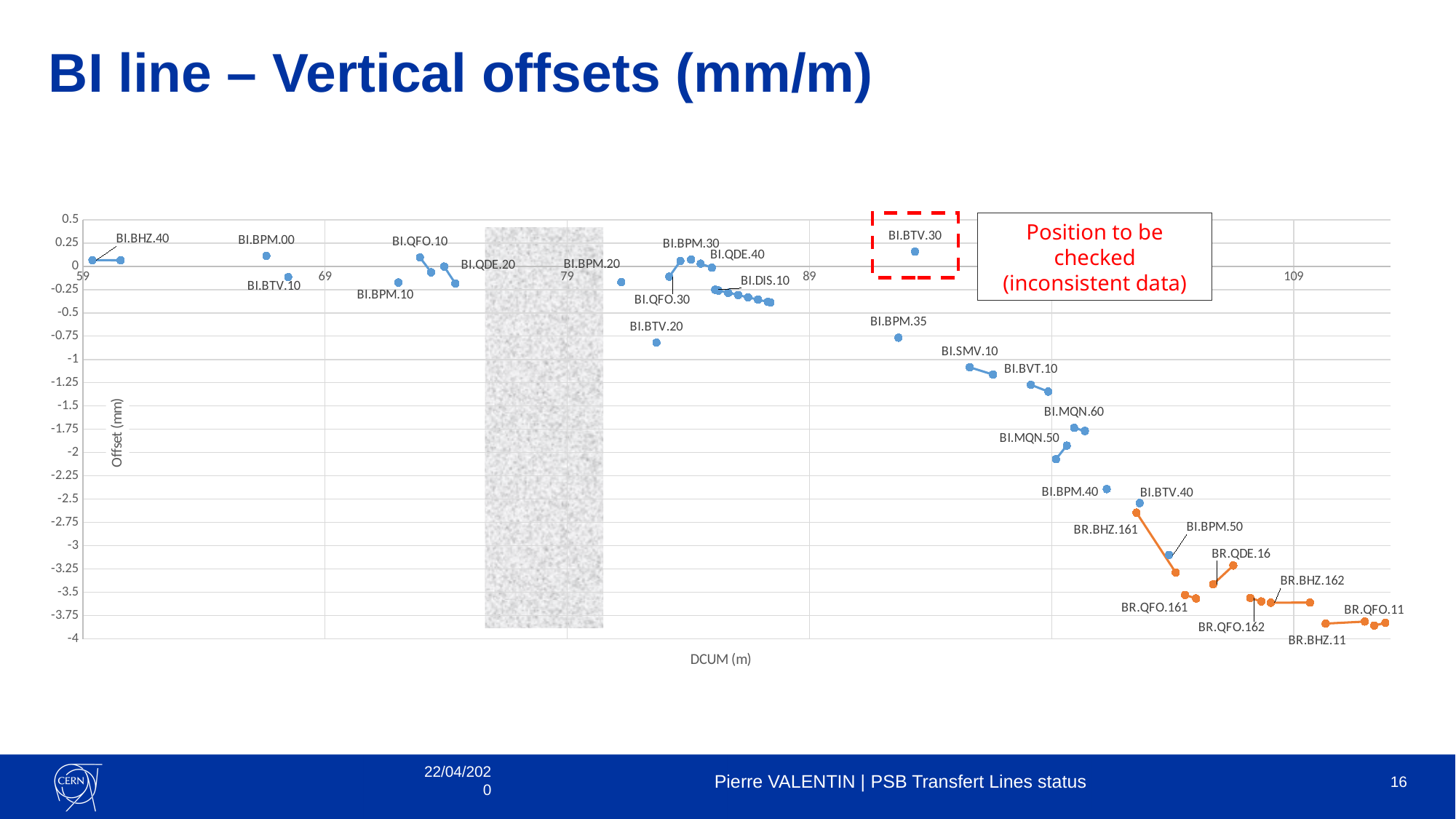
Is the offset value for BI.SMV.10 greater or less than -1? less Is the offset value for BR.QFO.11 greater or less than -3.75? less Which labelled point is enclosed by the red dashed box marked 'Position to be checked (inconsistent data)'? BI.BTV.30 Overall, do the plotted offset values rise or fall as DCUM increases along the x axis? fall What kind of chart is shown on the slide? scatter chart Is the offset value for BI.BTV.20 greater or less than -0.75? less Which has the higher offset value, BI.BPM.40 or BI.BTV.40? BI.BPM.40 What is the title of the x axis of the chart? DCUM (m) Which has the higher offset value, BI.SMV.10 or BI.BVT.10? BI.SMV.10